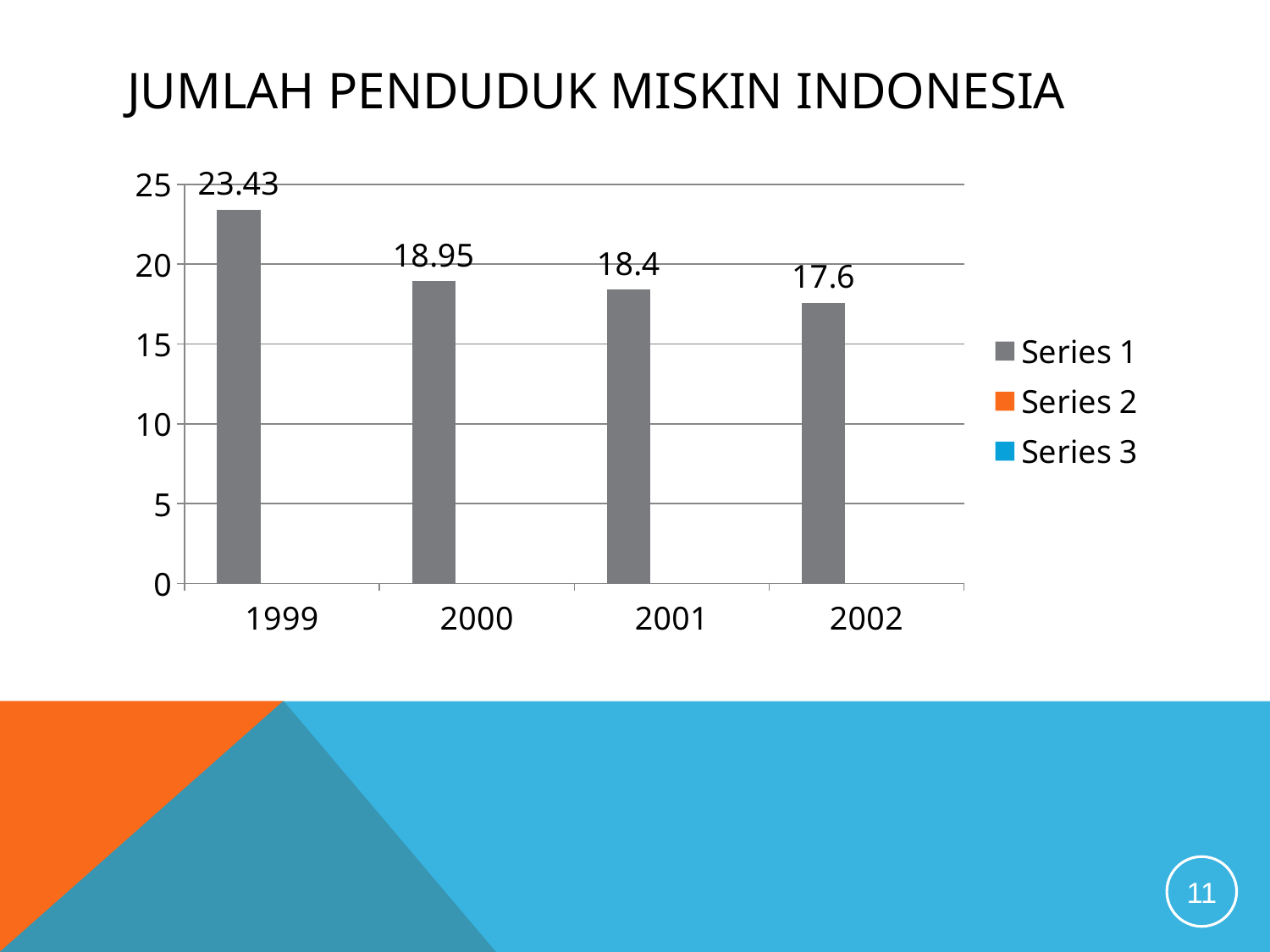
What is the difference between the values for 1999 and 2002? 5.83 Do the values rise or fall from 1999 to 2002? fall What is the value for 2001? 18.4 How many series does the legend list? 3 How many years are shown on the x axis? 4 Which year has the lowest value? 2002 Which year has the highest value? 1999 What is the value for 1999? 23.43 Which is larger, the value for 2000 or the value for 2001? 2000 What is the value for 2000? 18.95 Is the value for 2002 greater or less than 20? less What is the value for 2002? 17.6